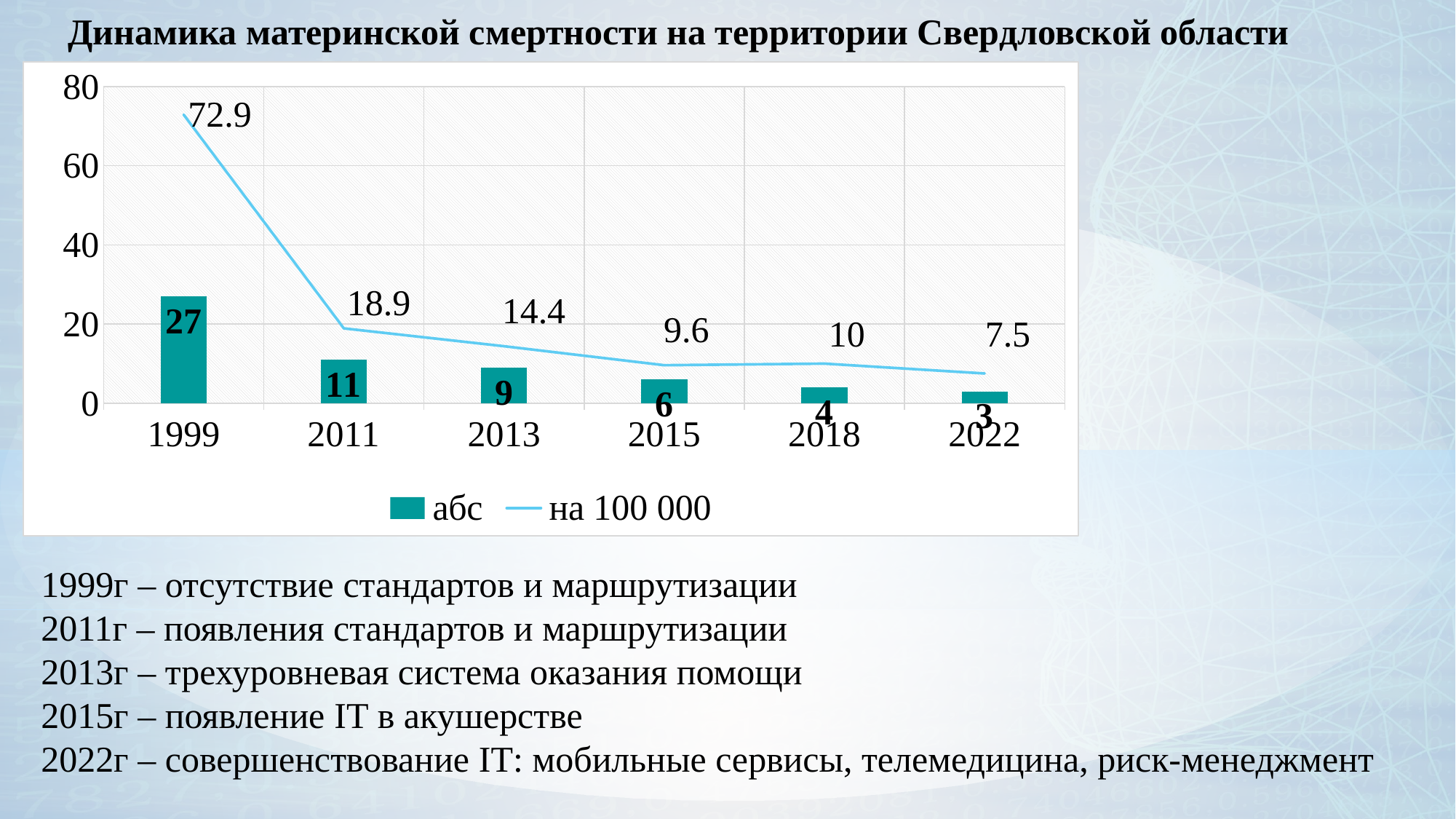
What is the value of the 'абс' series for 2018? 4 Which year has the highest value in the 'на 100 000' series? 1999 How many series does the legend list? 2 Which is larger in the 'на 100 000' series: 2015 or 2018? 2018 What is the value of the 'на 100 000' series for 2011? 18.9 Which year has the lowest value in the 'абс' series? 2022 What is the difference between the 'на 100 000' values for 2013 and 2015? 4.8 What is the value of the 'абс' series for 1999? 27 What is the difference between the 'абс' values for 1999 and 2011? 16 What is the value of the 'на 100 000' series for 2022? 7.5 How many years are shown on the x axis? 6 Does the 'абс' series rise or fall from 1999 to 2022? fall